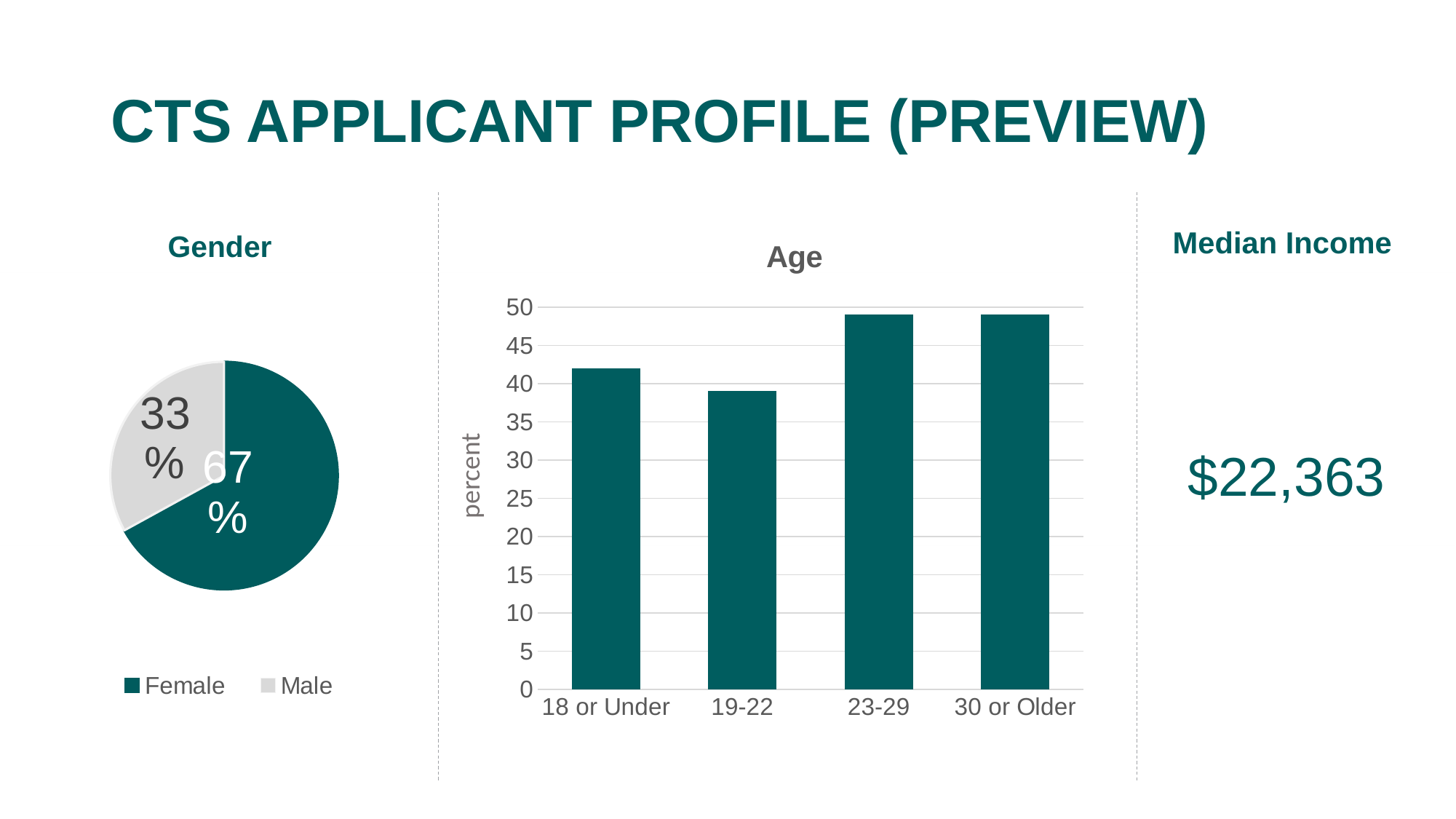
In the Gender pie chart, what share of applicants is Female? 67% What is the label on the vertical axis of the Age chart? percent How many age categories are shown in the Age chart? 4 In the Gender pie chart, what share of applicants is Male? 33% In the Gender pie chart, what is the difference in percentage points between the Female and Male shares? 34 In the Age chart, is the value for 23-29 greater or less than 45? greater In the Age chart, is the value for 19-22 greater or less than 40? less What kind of chart is the Age chart? Bar chart In the Age chart, which category has the lowest value? 19-22 What kind of chart is the Gender chart? Pie chart In the Gender pie chart, which slice is larger, Female or Male? Female How many entries does the legend of the Gender chart list? 2